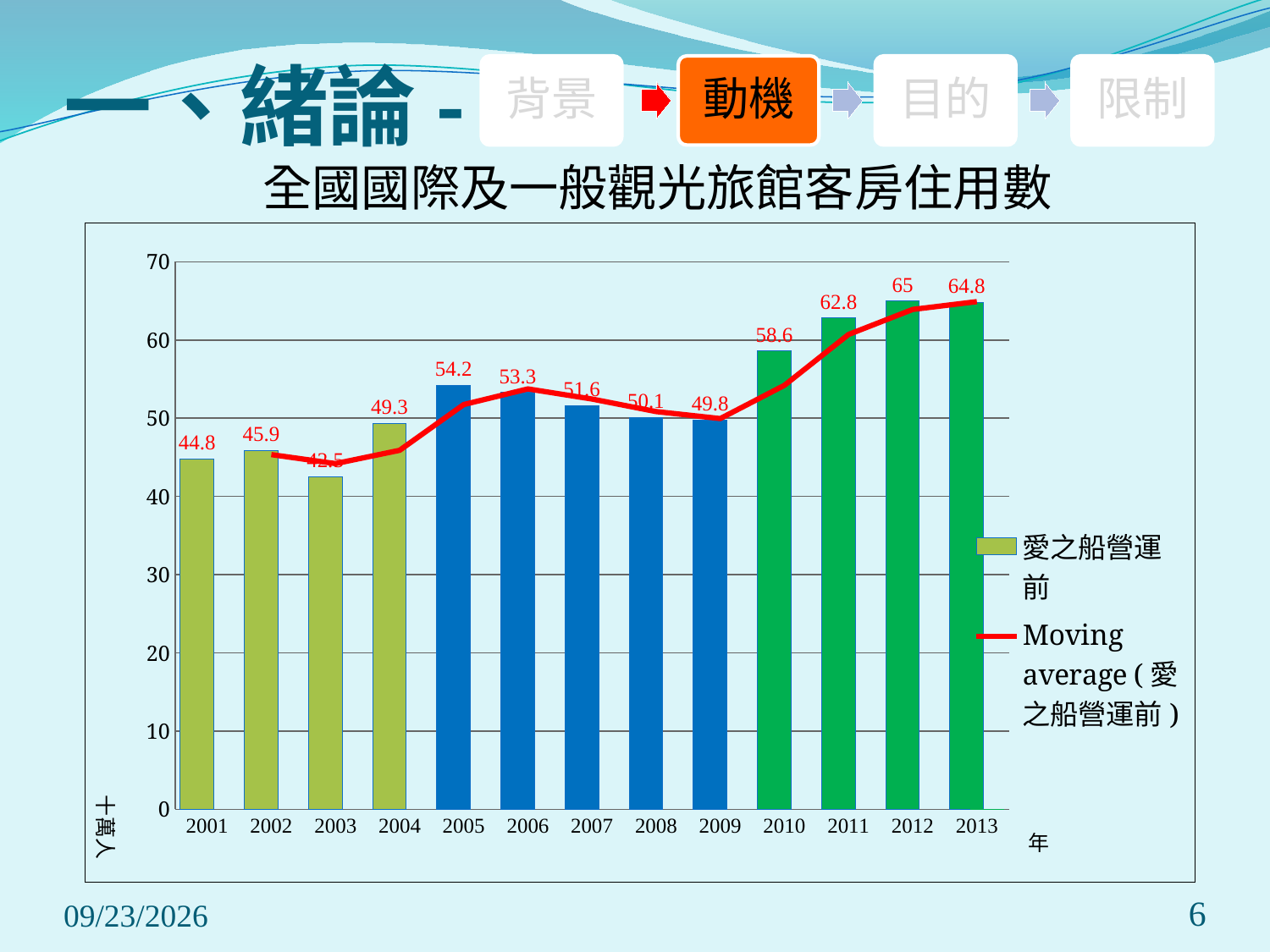
Do the values rise or fall from 2005 to 2009? fall Is the value for 2010 greater or less than 50? greater What is the value for 2011? 62.8 Which year has the larger value, 2006 or 2007? 2006 What kind of chart is this? bar chart Which year has the lowest value? 2003 Which year has the highest value? 2012 How many years are shown on the x axis? 13 What is the value for 2005? 54.2 What is the difference between the values for 2013 and 2001? 20 How many entries does the legend list? 2 What is the title of the chart? 全國國際及一般觀光旅館客房住用數